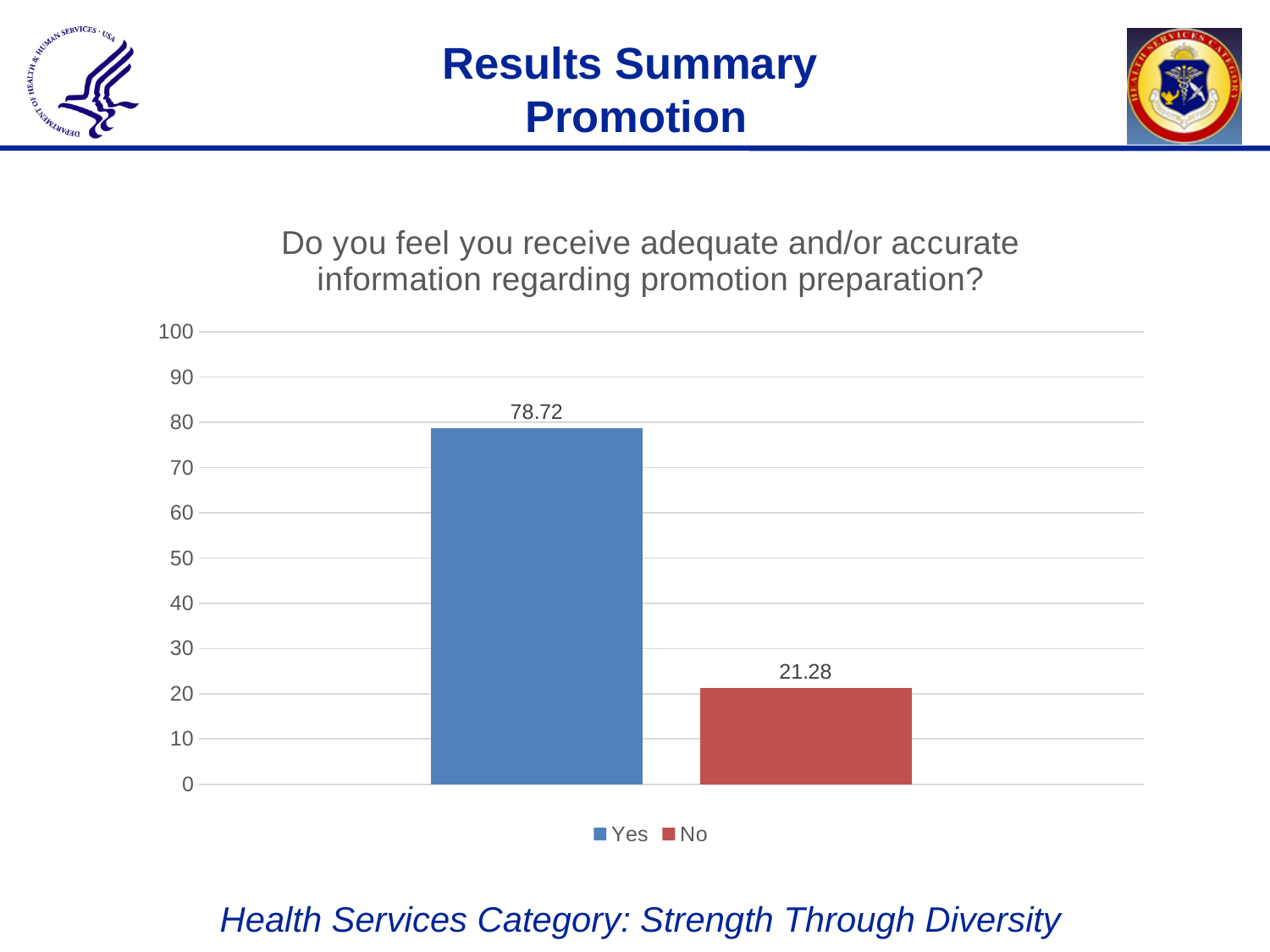
What kind of chart is shown on the slide? Bar chart Is the value for No greater or less than 30? less How many bars are plotted in the chart? 2 Which response has the highest value? Yes Is the value for Yes greater or less than 70? greater Which response has the lowest value? No How many series does the legend list? 2 Which is larger, the value for Yes or the value for No? Yes What is the value for No? 21.28 What is the value for Yes? 78.72 What is the difference between the Yes and No values? 57.44 What colour is the bar for No? Red